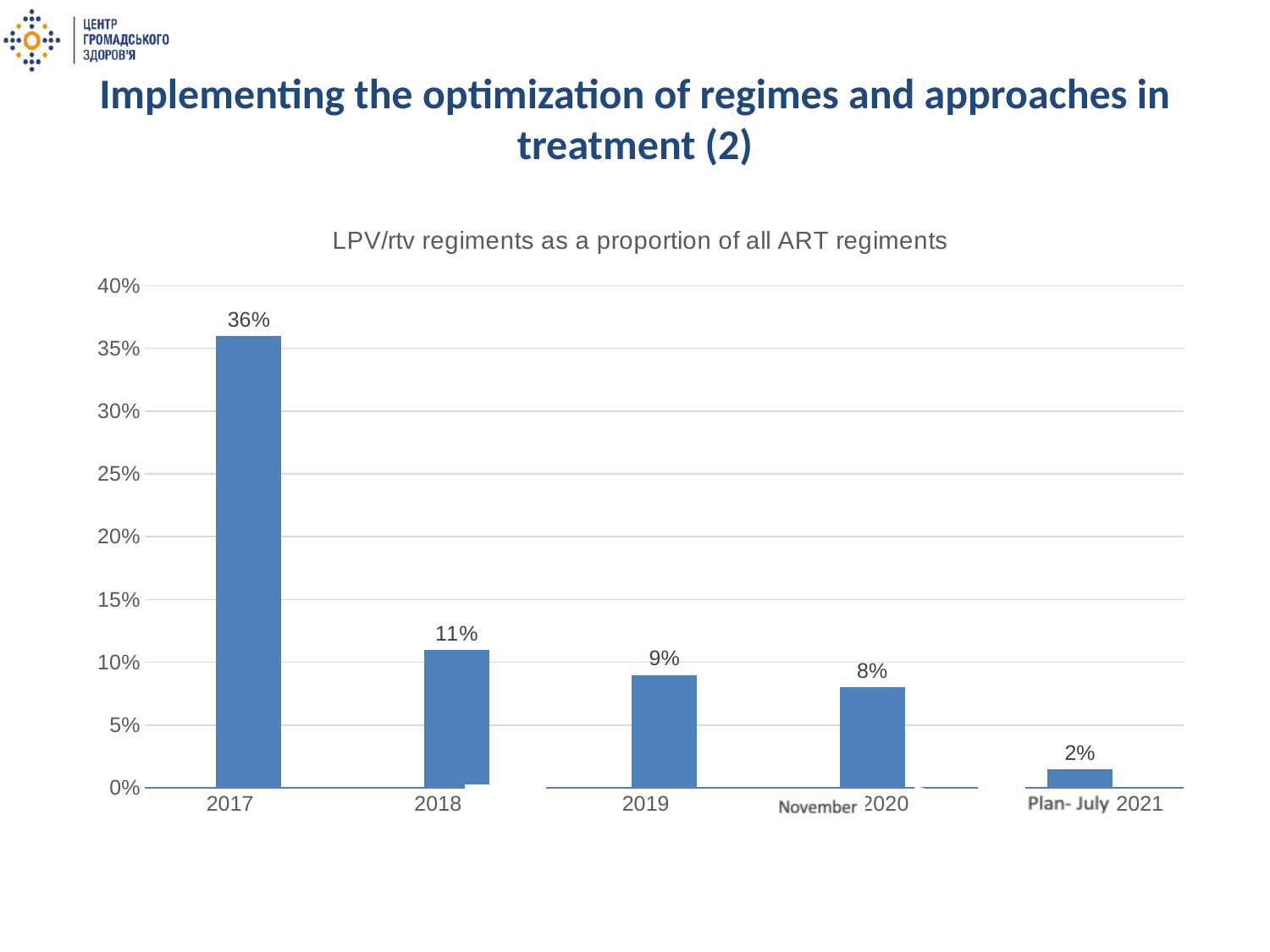
What is the difference between the values for 2017 and 2018? 25% What is the value for November 2020? 8% Do the values rise or fall from 2017 to Plan-July 2021? fall How many categories are shown on the x axis? 5 What is the value for 2017? 36% Which category has the highest value? 2017 Which is larger, the value for 2019 or the value for November 2020? 2019 What is the title of the chart? LPV/rtv regiments as a proportion of all ART regiments What is the value for Plan-July 2021? 2% What is the value for 2018? 11% What kind of chart is this? bar chart Which category has the lowest value? Plan-July 2021